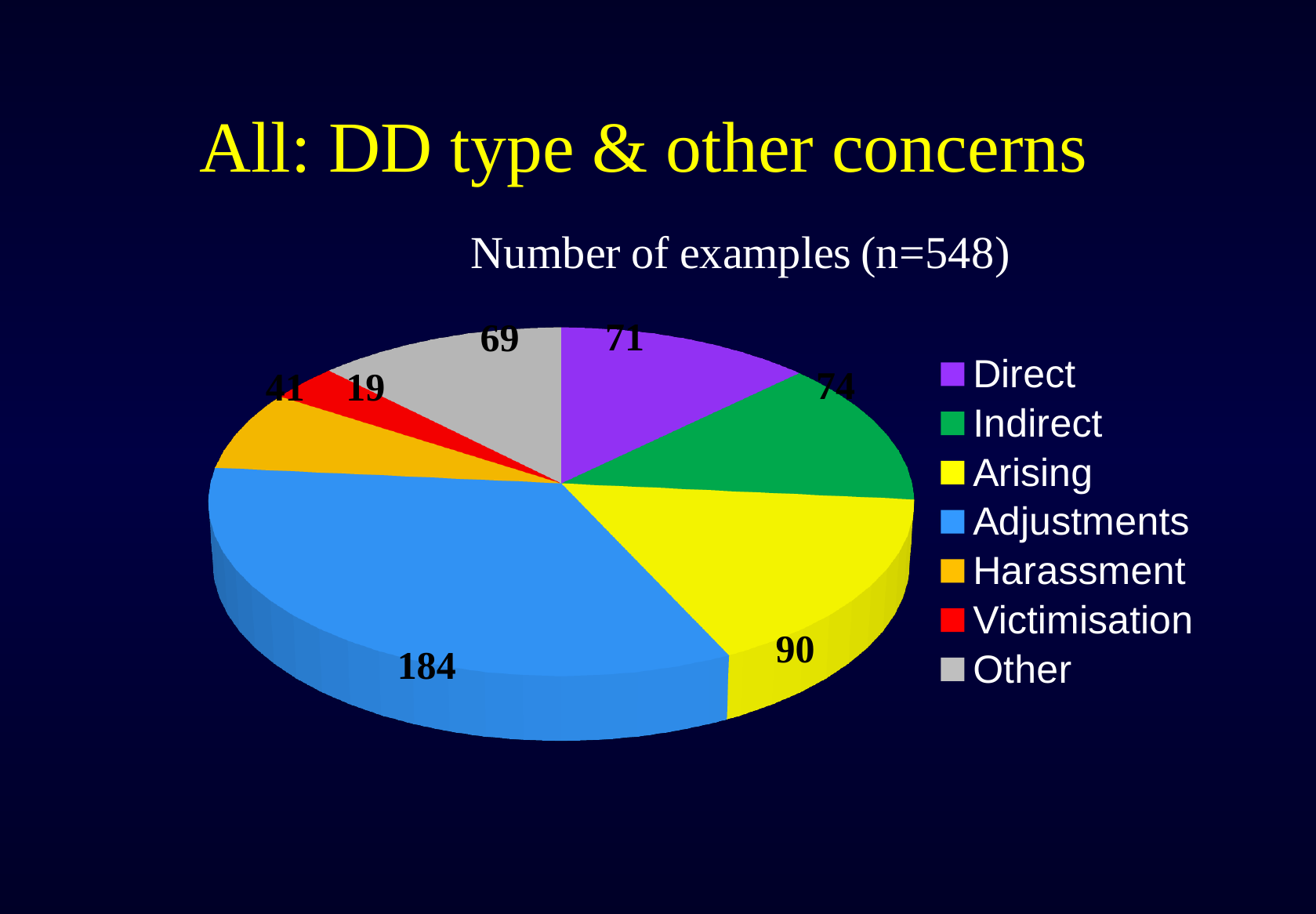
What is the number of examples for Arising? 90 What is the difference between the number of examples for Harassment and Victimisation? 22 What is the number of examples for Victimisation? 19 What is the number of examples for Other? 69 What is the number of examples for Adjustments? 184 How many categories does the pie chart show? 7 Which category has the largest number of examples? Adjustments Which has more examples, Direct or Harassment? Direct Which category has the smallest number of examples? Victimisation What is the difference between the number of examples for Adjustments and Arising? 94 What colour is the Adjustments slice? Blue What kind of chart is shown on the slide? Pie chart